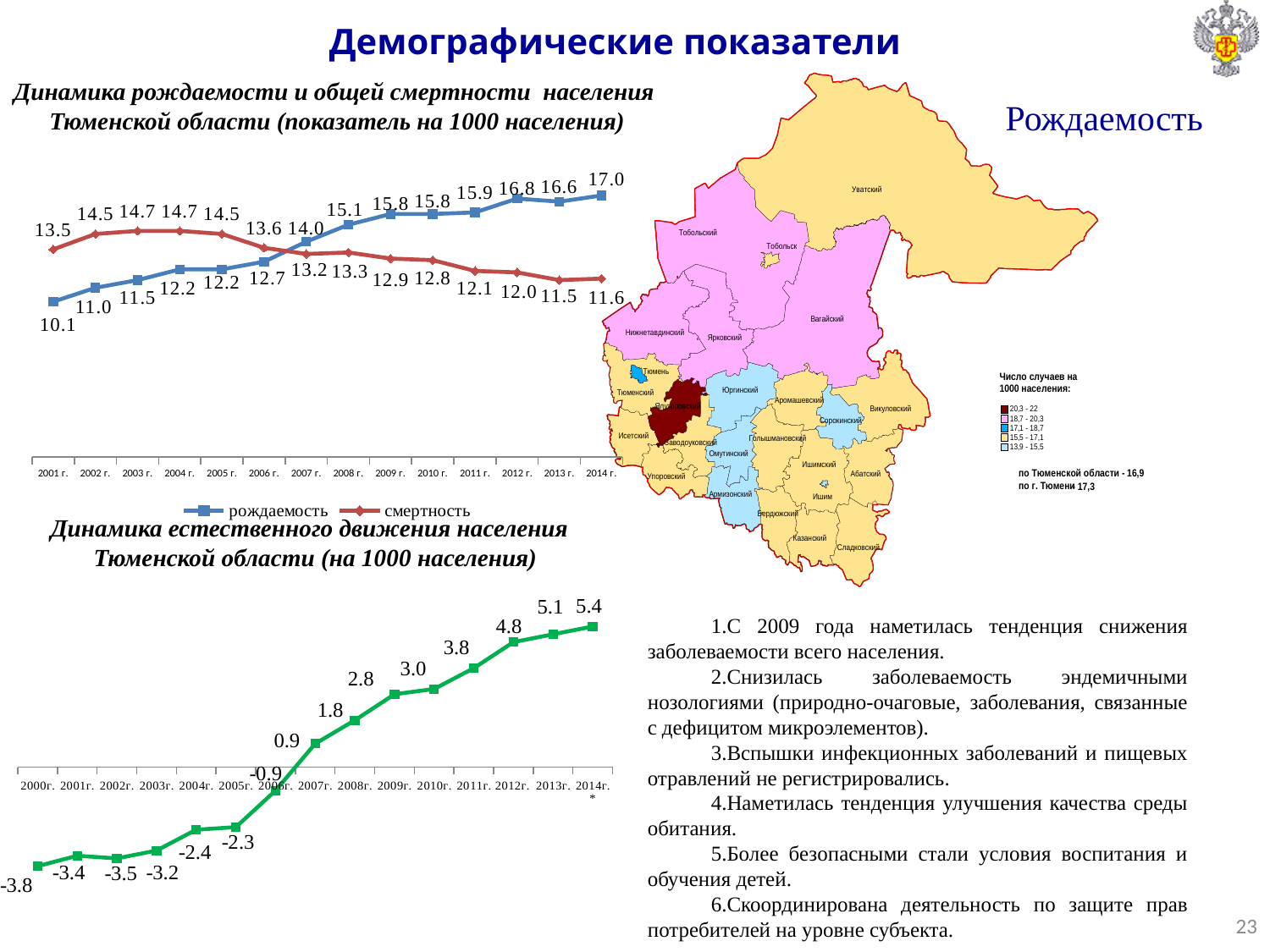
How many series does the legend of the chart 'Динамика рождаемости и общей смертности населения Тюменской области' list? 2 How many years are plotted in the chart 'Динамика естественного движения населения Тюменской области'? 15 In the chart 'Динамика рождаемости и общей смертности населения Тюменской области', which is larger in 2003 г., рождаемость or смертность? смертность In the chart 'Динамика рождаемости и общей смертности населения Тюменской области', what is the value of рождаемость in 2001 г.? 10.1 In the chart 'Динамика естественного движения населения Тюменской области', do the values generally rise or fall from 2000г. to 2014г.? rise In the chart 'Динамика естественного движения населения Тюменской области', what is the value for 2006г.? -0.9 In the chart 'Динамика рождаемости и общей смертности населения Тюменской области', in which year is рождаемость highest? 2014 г. In the chart 'Динамика рождаемости и общей смертности населения Тюменской области', in which year is смертность lowest? 2013 г. In the chart 'Динамика рождаемости и общей смертности населения Тюменской области', what is the value of смертность in 2014 г.? 11.6 What kind of chart is 'Динамика рождаемости и общей смертности населения Тюменской области'? line chart In the chart 'Динамика рождаемости и общей смертности населения Тюменской области', what is the difference between рождаемость and смертность in 2014 г.? 5.4 In the chart 'Динамика естественного движения населения Тюменской области', which year has the lowest value? 2000г.